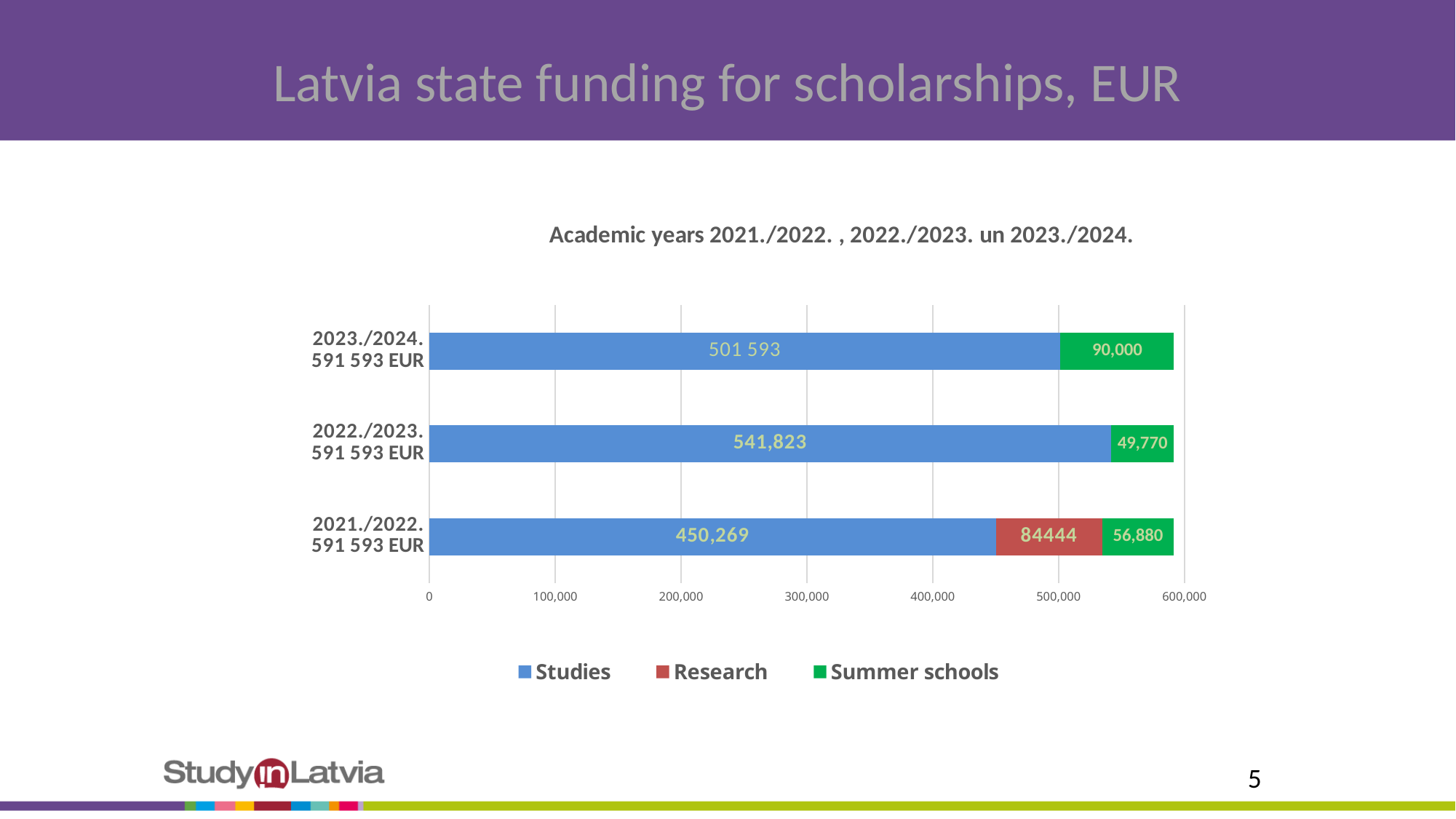
What is the Research value for 2021./2022.? 84444 What kind of chart is shown on the slide? Stacked bar chart What is the total of the stacked bar for 2021./2022.? 591 593 EUR What is the difference between the Studies values for 2022./2023. and 2021./2022.? 91,554 Which academic year has the lowest Studies value? 2021./2022. Which is larger, the Summer schools value for 2023./2024. or for 2021./2022.? 2023./2024. How many series does the legend list? 3 What is the difference between the Summer schools values for 2023./2024. and 2022./2023.? 40,230 What is the Studies value for 2023./2024.? 501 593 What is the Summer schools value for 2022./2023.? 49,770 How many academic years are shown in the chart? 3 Which academic year has the highest Studies value? 2022./2023.